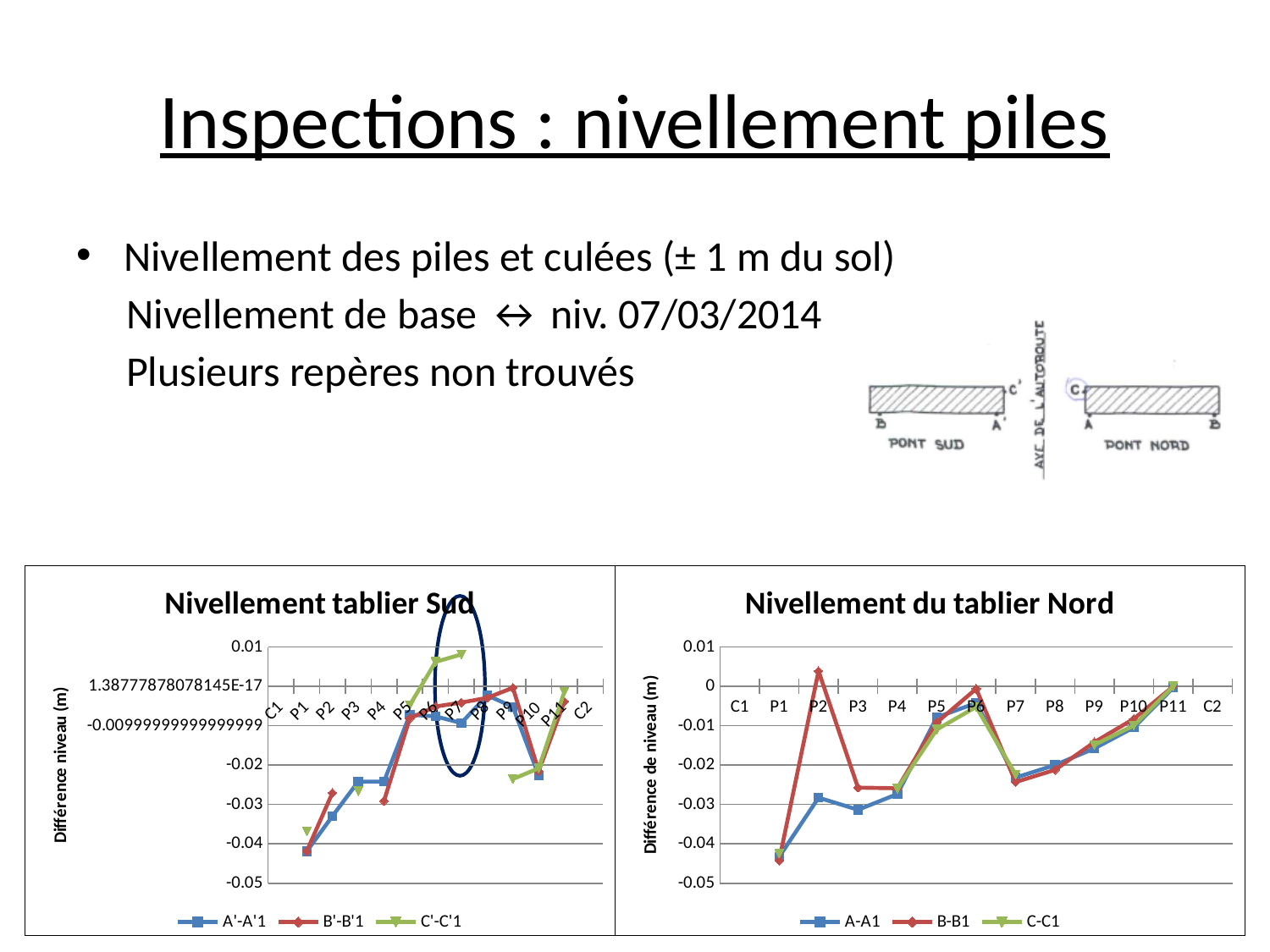
In the 'Nivellement du tablier Nord' chart, at which category does the A-A1 series reach its lowest value? P1 In the 'Nivellement du tablier Nord' chart, is the value of A-A1 at P7 greater or less than -0.03? greater In the 'Nivellement tablier Sud' chart, is the value of C'-C'1 at P7 greater or less than 0? greater How many categories are shown on the x axis of the 'Nivellement du tablier Nord' chart? 13 What type of chart is 'Nivellement du tablier Nord'? line chart What are the legend entries of the 'Nivellement du tablier Nord' chart? A-A1, B-B1, C-C1 In the 'Nivellement du tablier Nord' chart, is the value of B-B1 at P1 greater or less than -0.04? less What is the y-axis title of the 'Nivellement du tablier Nord' chart? Différence de niveau (m) In the 'Nivellement du tablier Nord' chart, do the values of A-A1 rise or fall from P7 to P11? rise How many series does the legend of the 'Nivellement tablier Sud' chart list? 3 In the 'Nivellement du tablier Nord' chart, at which category does the B-B1 series reach its highest value? P2 In the 'Nivellement du tablier Nord' chart, which is larger at P2: A-A1 or B-B1? B-B1